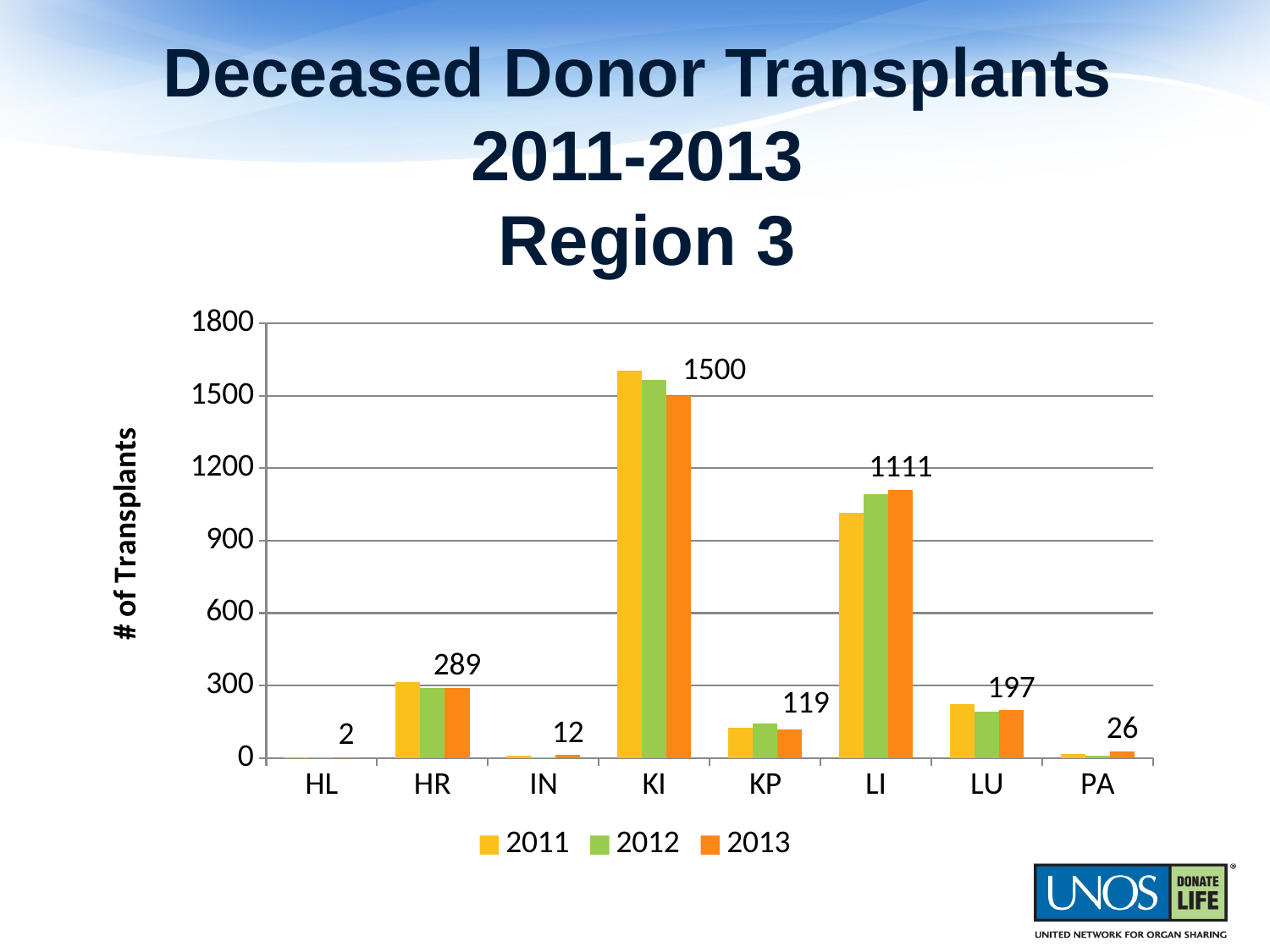
What is the 2013 value for HR? 289 What is the difference between the 2013 values for KI and LI? 389 Which category has the highest 2013 value? KI Which category has the lowest 2013 value? HL Which is larger in 2013, LU or KP? LU Is the 2011 value for KI greater or less than 1500? greater How many categories are shown on the x axis? 8 What is the 2013 value for PA? 26 What is the 2013 value for KI? 1500 What is the 2013 value for LI? 1111 What kind of chart is shown on the slide? bar chart How many series does the legend list? 3